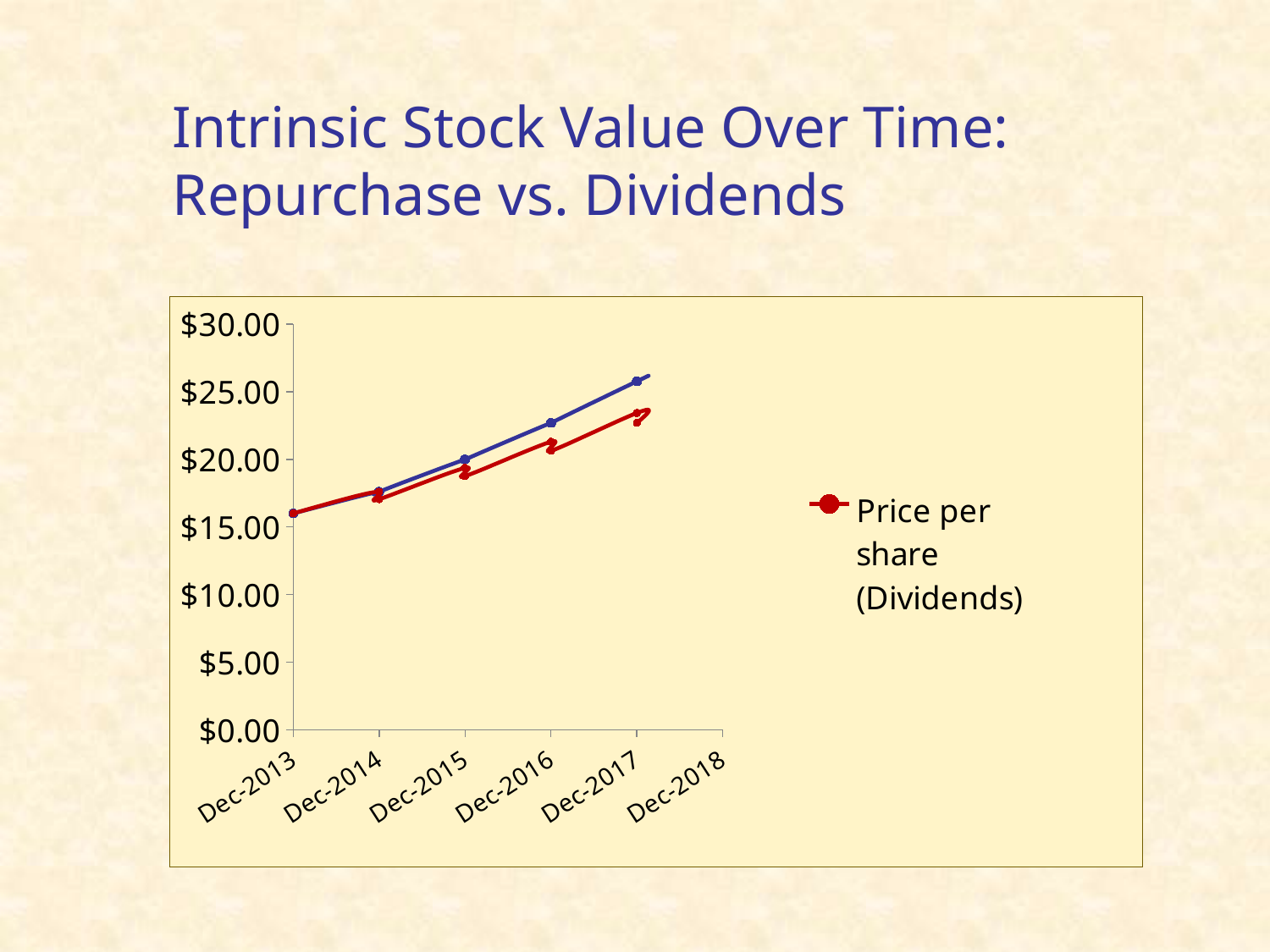
What is the name of the series listed in the legend? Price per share (Dividends) How many series does the legend list? 1 Is the value for Price per share (Dividends) at Dec-2016 greater or less than $25.00? less What is the highest value shown on the y axis? $30.00 Is the value of the blue line at Dec-2016 greater or less than $20.00? greater Is the value for Price per share (Dividends) at Dec-2013 greater or less than $15.00? greater Do the values of the Price per share (Dividends) line rise or fall from Dec-2013 to Dec-2017? rise How many date labels are shown on the x axis? 6 At Dec-2017, which is higher: the blue line or the Price per share (Dividends) line? the blue line What kind of chart is shown on the slide? line chart